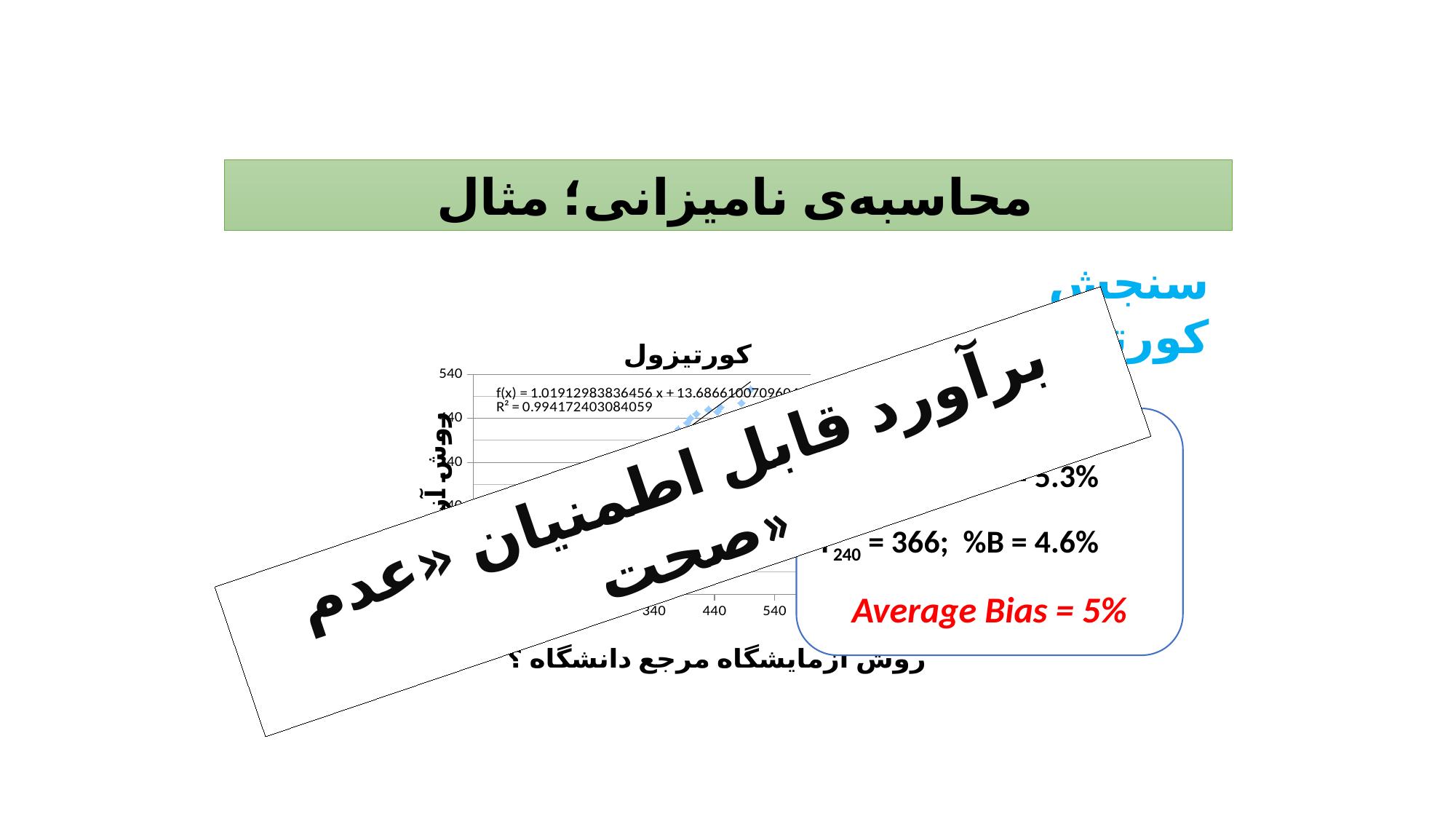
What is the title of the chart on the slide? کورتیزول What R² value is printed on the chart? 0.994172403084059 What kind of chart is shown on the slide? Scatter chart What is the highest tick value shown on the chart's x axis? 540